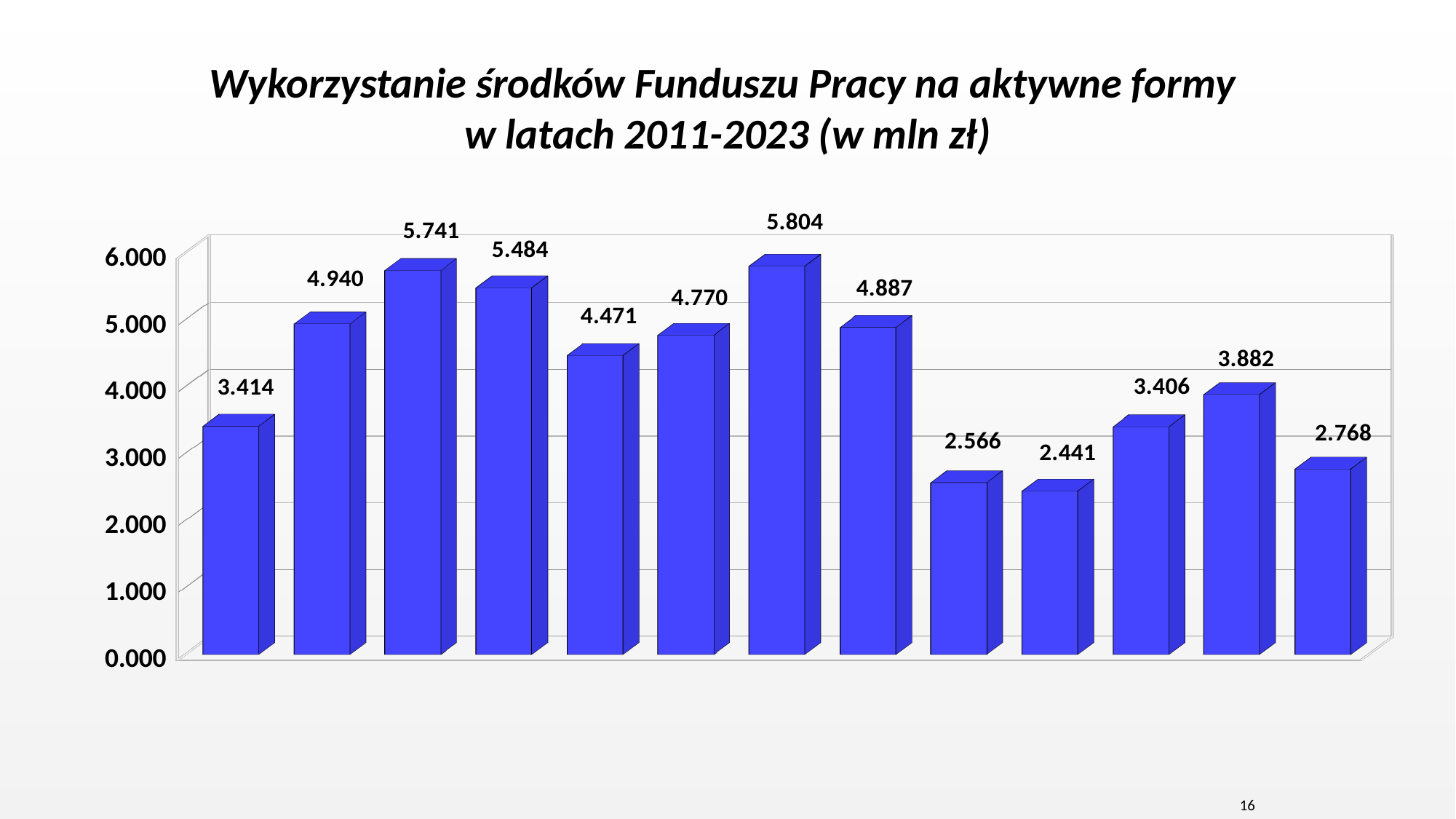
What is the value shown on the third bar from the left? 5.741 How many bars are plotted in the chart? 13 What is the difference between the highest bar (5.804) and the lowest bar (2.441)? 3.363 Do the values rise or fall from the seventh bar to the tenth bar? fall Is the value of the second bar from the left greater or less than 4.000? greater What type of chart is shown on the slide? bar chart What is the highest value labelled in the chart? 5.804 What is the difference between the first bar (3.414) and the last bar (2.768)? 0.646 What is the value shown on the last (rightmost) bar? 2.768 Which is larger, the third bar (5.741) or the fourth bar (5.484)? the third bar (5.741) What is the lowest value labelled in the chart? 2.441 What is the value shown on the first (leftmost) bar? 3.414